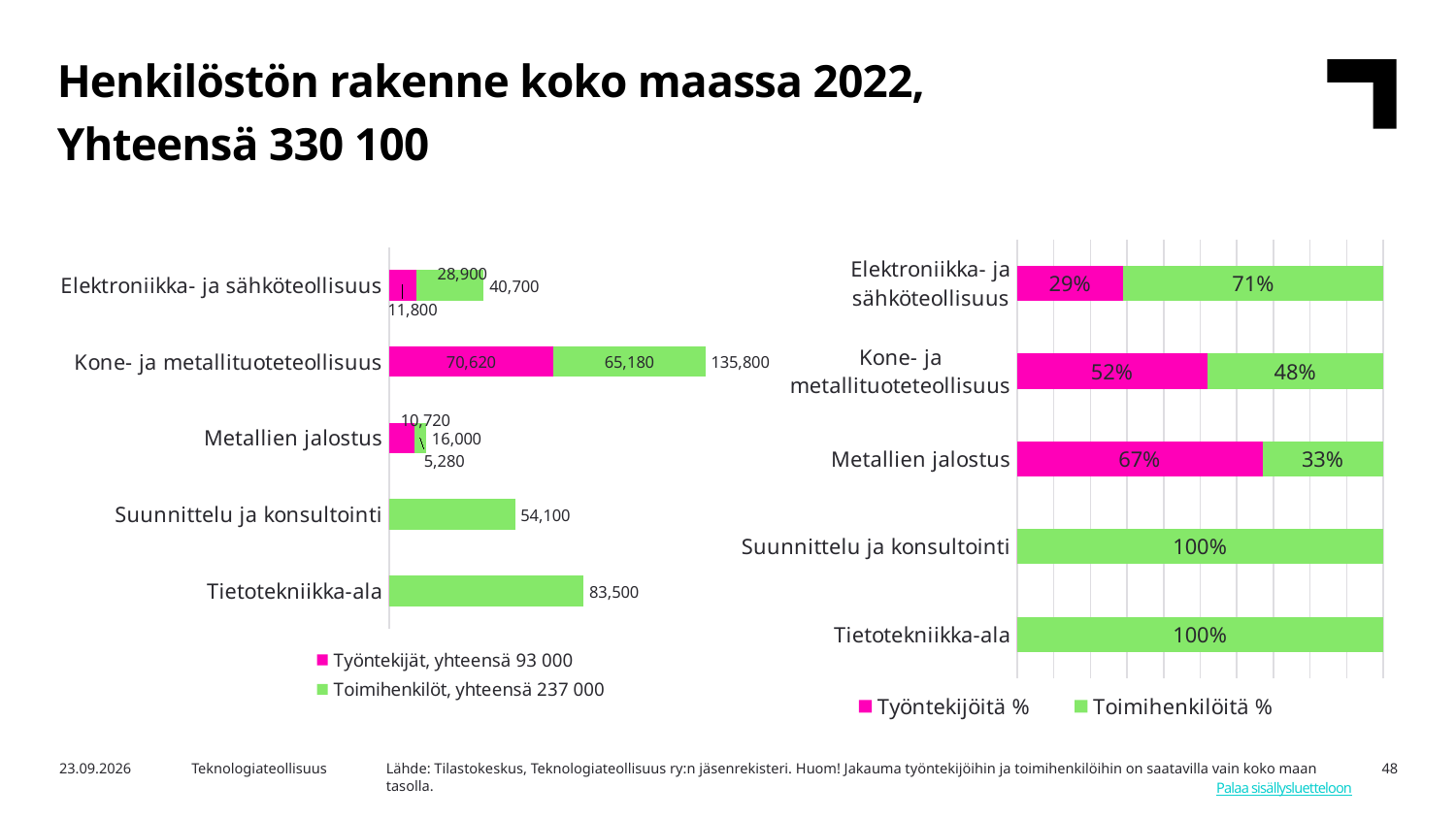
In the left chart, what is the difference between the Tietotekniikka-ala value and the Suunnittelu ja konsultointi value? 29,400 In the right chart, what is the Työntekijöitä % for Metallien jalostus? 67% In the left chart, which category has the lowest total value? Metallien jalostus In the right chart, what is the Toimihenkilöitä % for Elektroniikka- ja sähköteollisuus? 71% How many categories are shown in the right chart? 5 In the left chart, what is the Toimihenkilöt value for Kone- ja metallituoteteollisuus? 65,180 In the left chart, what is the total shown for the Metallien jalostus bar? 16,000 In the left chart, which category has the highest total value? Kone- ja metallituoteteollisuus What type of chart is the left chart? Stacked bar chart In the left chart, what is the Työntekijät value for Elektroniikka- ja sähköteollisuus? 11,800 In the right chart, which category has the highest Työntekijöitä %? Metallien jalostus In the left chart, which is larger for Kone- ja metallituoteteollisuus: Työntekijät or Toimihenkilöt? Työntekijät